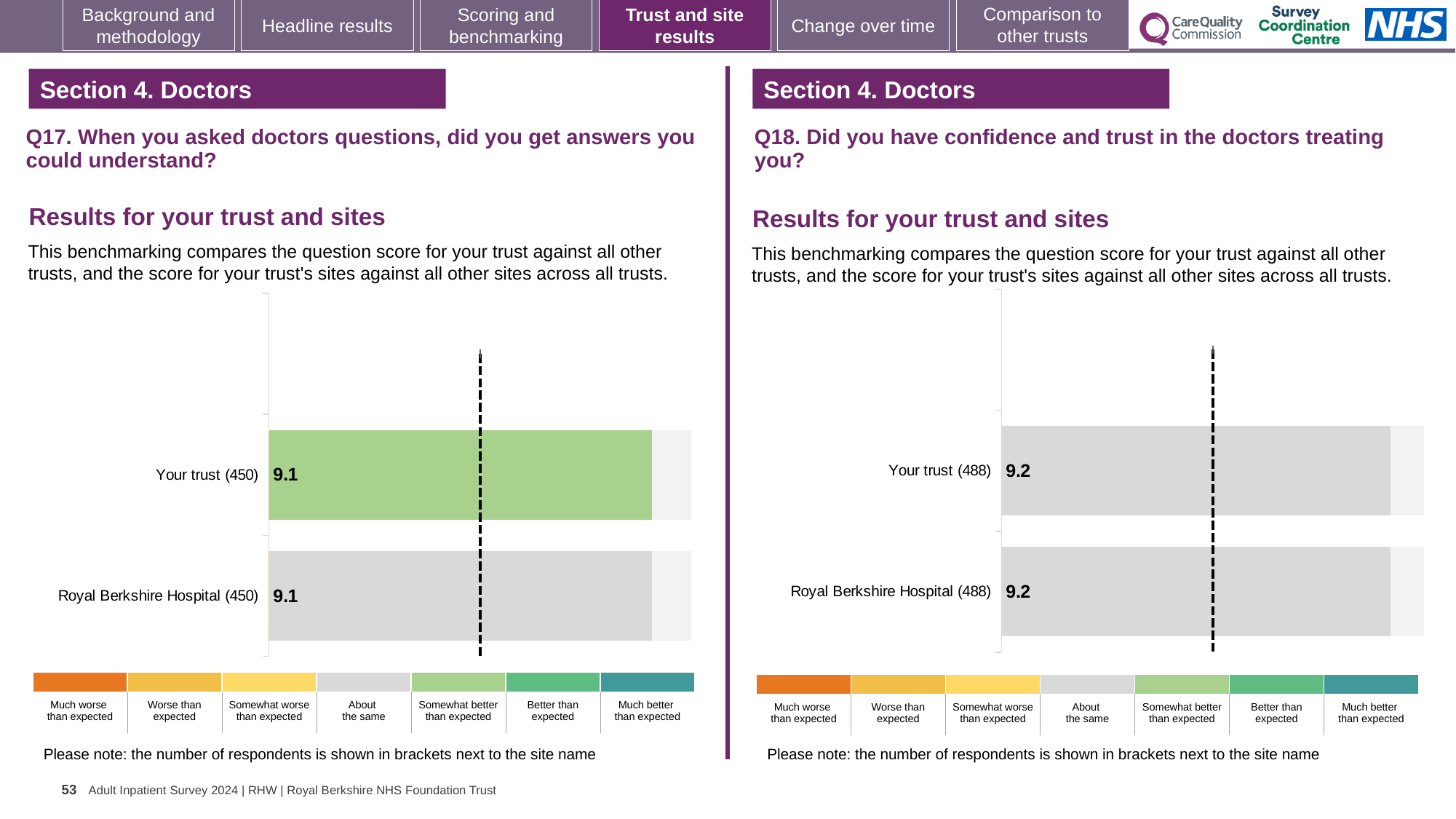
In the Q18 chart, how many respondents are shown in brackets for Royal Berkshire Hospital? 488 In the Q17 chart, which benchmark category does the colour of the Your trust bar correspond to in the legend? Somewhat better than expected In the Q17 chart, what is the score for Your trust (450)? 9.1 What type of chart is used for the Q18 results? Bar chart In the Q18 chart, what is the score for Royal Berkshire Hospital (488)? 9.2 In the Q18 chart, what is the score for Your trust (488)? 9.2 How many bars are plotted in the Q17 chart? 2 In the Q18 chart, what is the difference between the score for Your trust and the score for Royal Berkshire Hospital? 0 In the Q17 chart, what is the score for Royal Berkshire Hospital (450)? 9.1 How many bars are plotted in the Q18 chart? 2 In the Q17 chart, how many respondents are shown in brackets for Your trust? 450 In the Q17 chart, what is the difference between the score for Your trust and the score for Royal Berkshire Hospital? 0